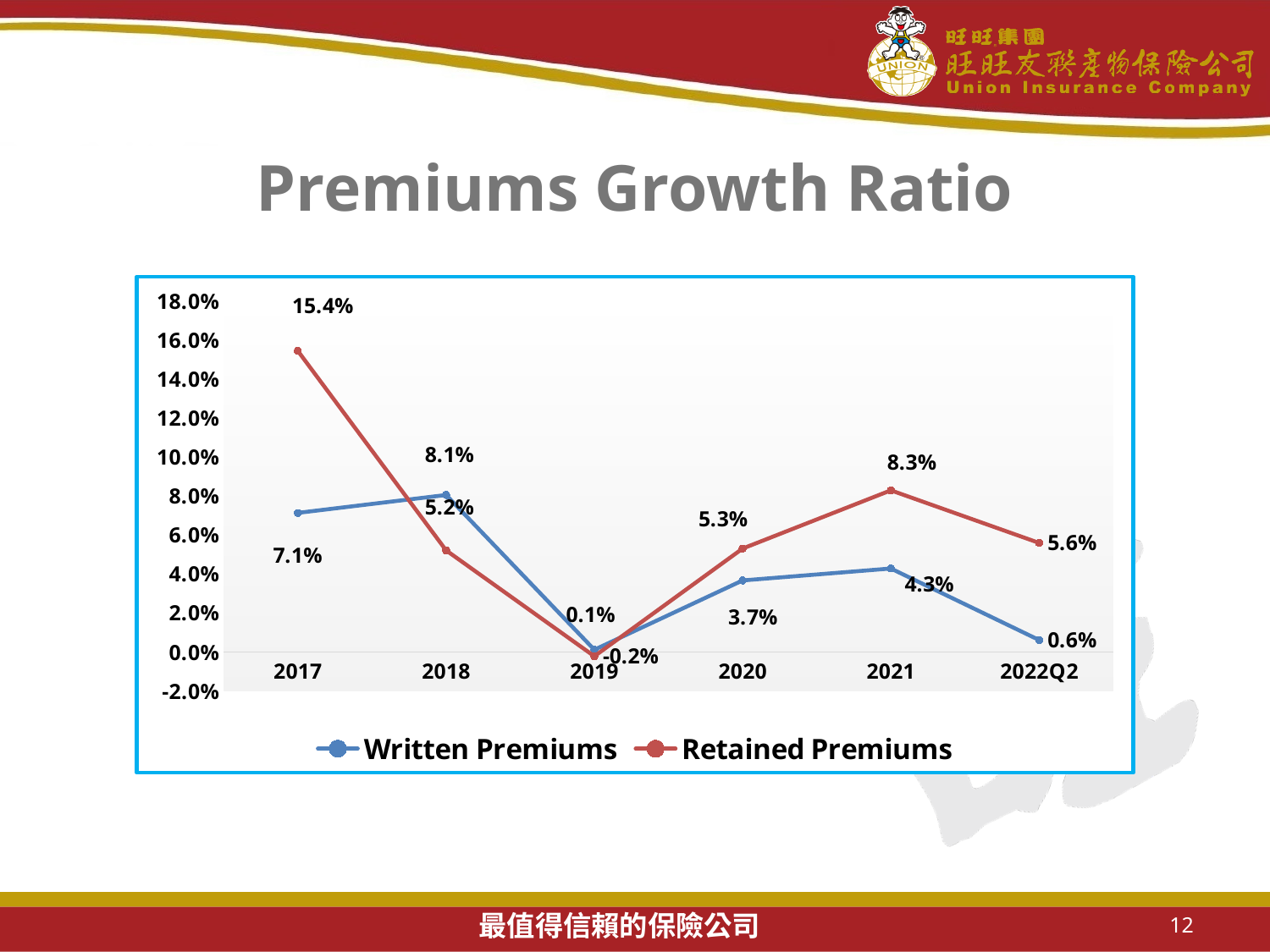
In which year is the Retained Premiums growth ratio highest? 2017 What is the Retained Premiums growth ratio in 2017? 15.4% In 2018, which series has the higher growth ratio, Written Premiums or Retained Premiums? Written Premiums How many time periods are shown on the x axis? 6 What is the title of the chart? Premiums Growth Ratio How many series does the legend list? 2 In which period is the Written Premiums growth ratio lowest? 2019 What type of chart is shown on the slide? line chart What is the Written Premiums growth ratio in 2022Q2? 0.6% What is the Written Premiums growth ratio in 2018? 8.1% What is the difference between Retained Premiums and Written Premiums growth ratios in 2021? 4.0% What is the Retained Premiums growth ratio in 2019? -0.2%